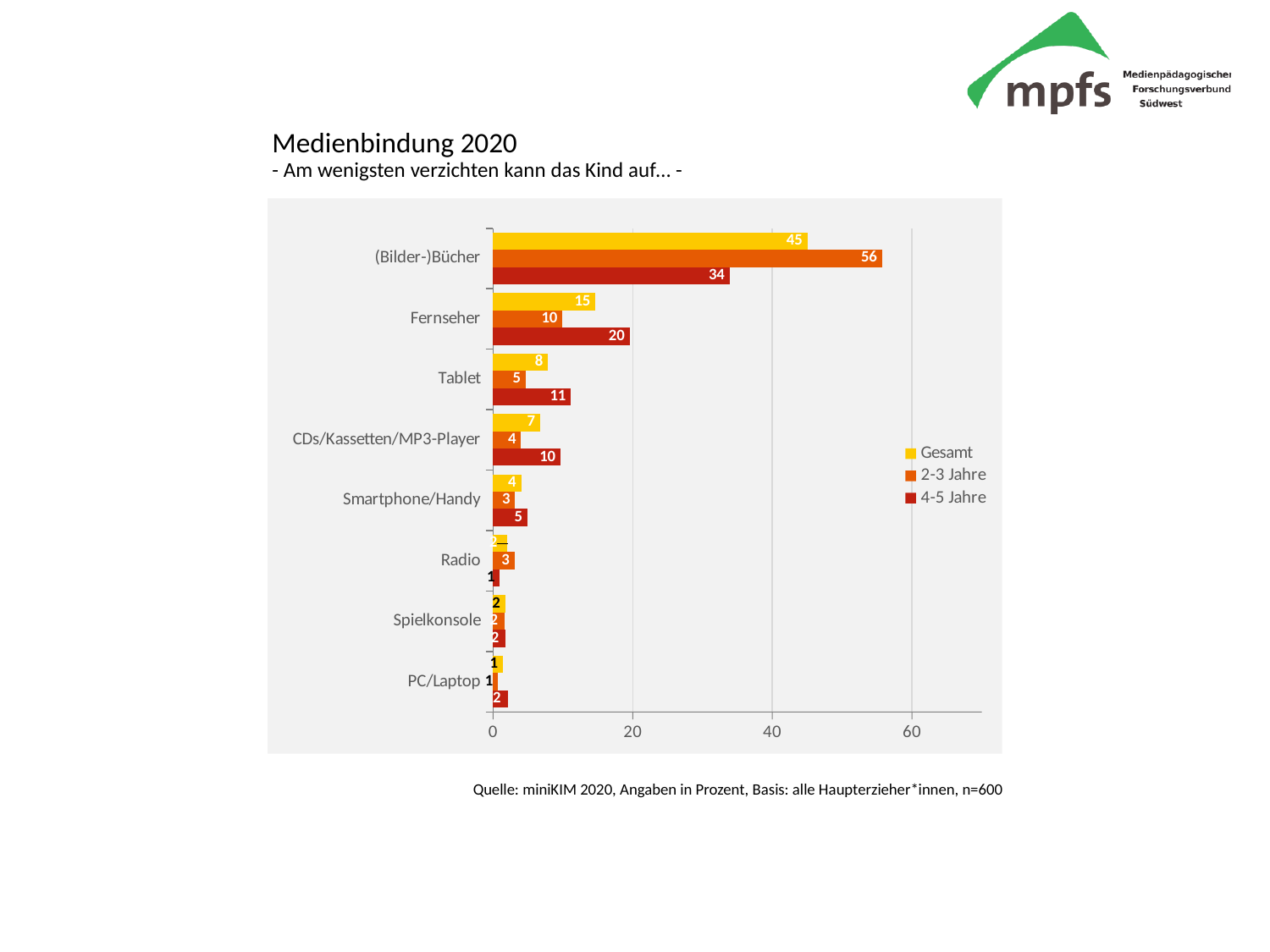
What is the difference between the 2-3 Jahre and 4-5 Jahre values for (Bilder-)Bücher? 22 Which category has the highest Gesamt value? (Bilder-)Bücher How many series does the legend list? 3 What kind of chart is shown on the slide? bar chart What is the value for (Bilder-)Bücher in the 2-3 Jahre series? 56 What is the value for Tablet in the 4-5 Jahre series? 11 What is the 2-3 Jahre value for CDs/Kassetten/MP3-Player? 4 How many categories are shown on the chart? 8 What is the difference between the 4-5 Jahre and 2-3 Jahre values for Fernseher? 10 What is the Gesamt value for Fernseher? 15 Which is larger for Smartphone/Handy: the 2-3 Jahre value or the 4-5 Jahre value? 4-5 Jahre Is the Gesamt value for (Bilder-)Bücher greater or less than 40? greater